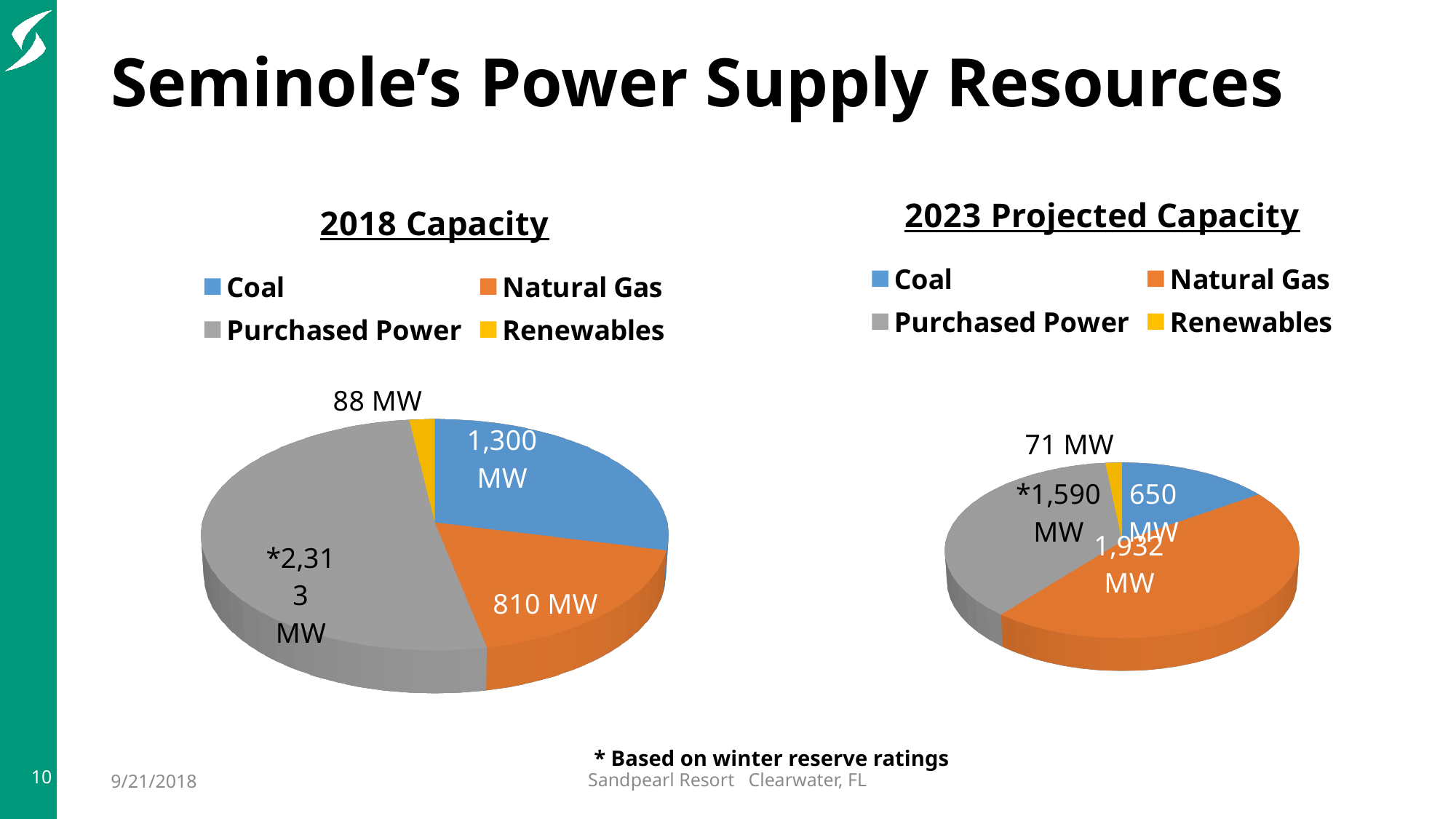
In the 2018 Capacity chart, what is the value for Coal? 1,300 MW What kind of chart is the 2018 Capacity chart? Pie chart In the 2023 Projected Capacity chart, which category has the smallest slice? Renewables In the 2023 Projected Capacity chart, which is larger, Natural Gas or Purchased Power? Natural Gas In the 2023 Projected Capacity chart, what is the value for Renewables? 71 MW How many entries does the legend of the 2023 Projected Capacity chart list? 4 In the 2023 Projected Capacity chart, what is the value for Natural Gas? 1,932 MW In the 2018 Capacity chart, what is the value for Purchased Power? 2,313 MW In the 2023 Projected Capacity chart, what colour is the Purchased Power slice? Grey How many categories does the 2018 Capacity chart show? 4 In the 2018 Capacity chart, which category has the largest slice? Purchased Power In the 2018 Capacity chart, what is the difference between Coal and Natural Gas? 490 MW